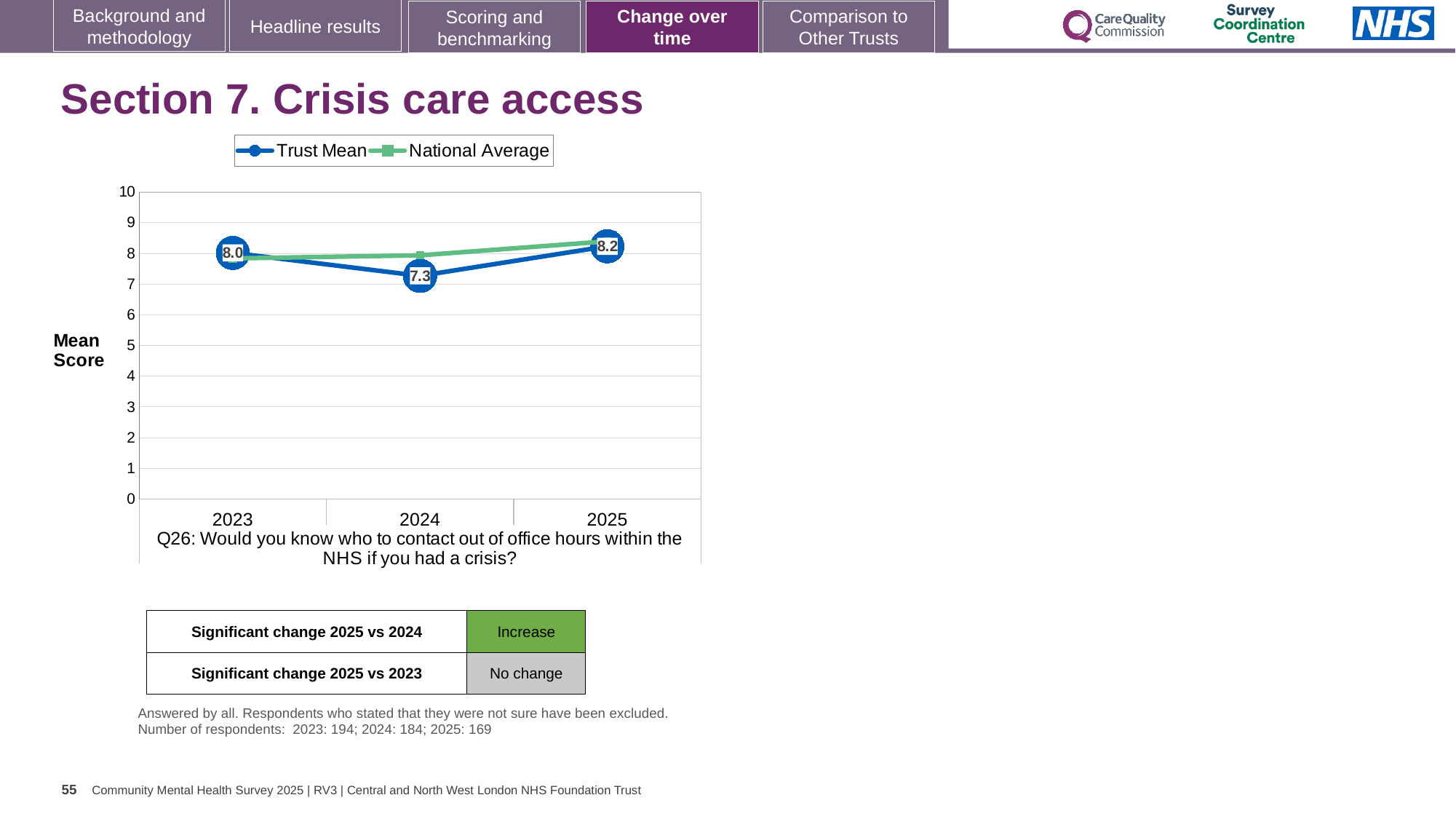
What is the Trust Mean value for 2024? 7.3 In which year is the Trust Mean lowest? 2024 What is the Trust Mean value for 2025? 8.2 What is the Trust Mean value for 2023? 8.0 How many years are shown on the x axis? 3 What kind of chart is shown on the slide? Line chart In 2024, which is larger: the Trust Mean or the National Average? National Average What is the difference between the Trust Mean in 2025 and in 2024? 0.9 In which year is the Trust Mean highest? 2025 Is the National Average value for 2025 greater or less than 8? greater How many series does the legend list? 2 Does the Trust Mean rise or fall from 2024 to 2025? Rise